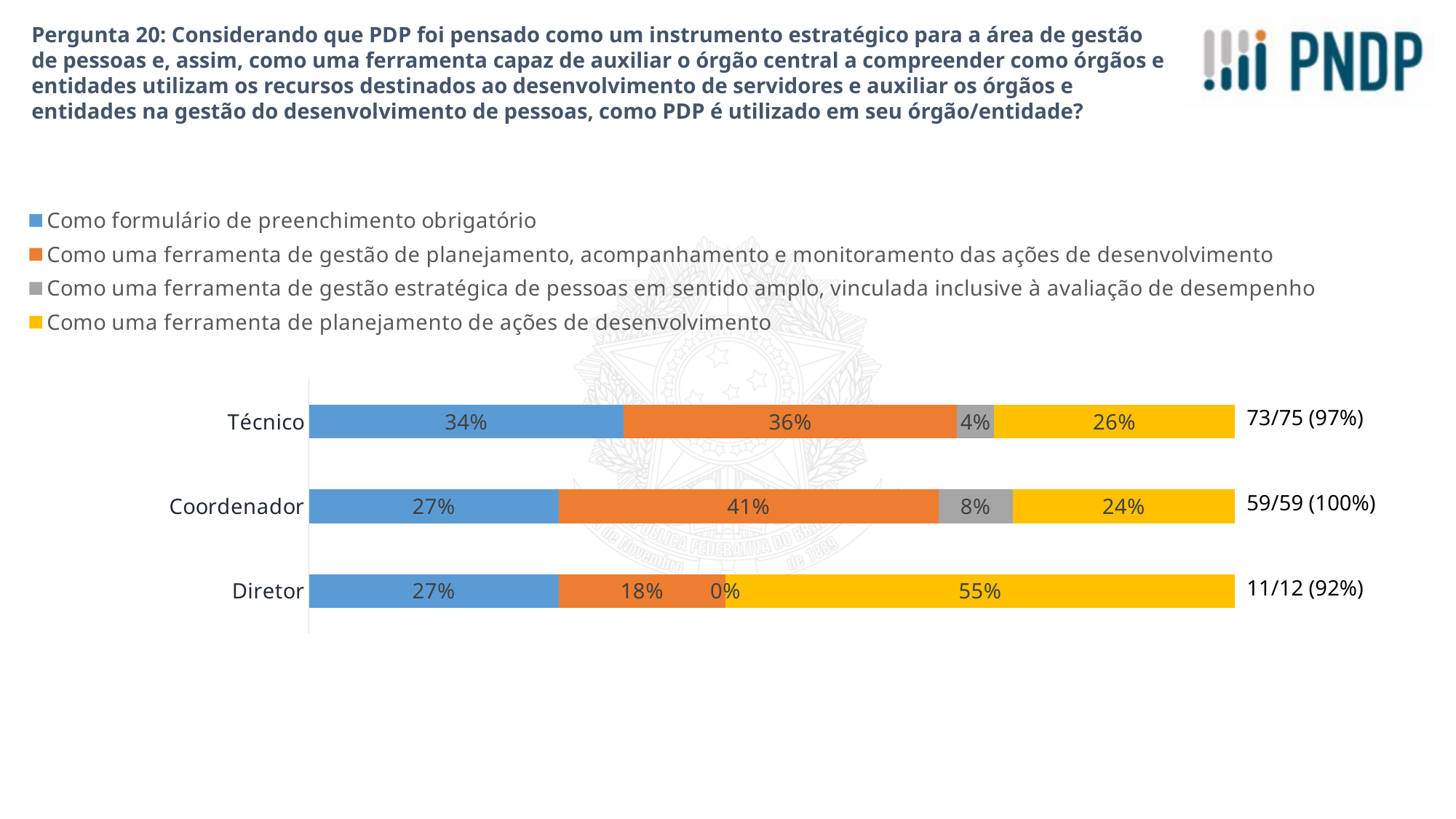
What is the difference between the Diretor and Técnico shares for 'Como uma ferramenta de planejamento de ações de desenvolvimento'? 29 percentage points Which job role has the lowest share for 'Como uma ferramenta de gestão estratégica de pessoas em sentido amplo, vinculada inclusive à avaliação de desempenho'? Diretor What percentage of Coordenador respondents chose 'Como uma ferramenta de gestão estratégica de pessoas em sentido amplo, vinculada inclusive à avaliação de desempenho'? 8% Which is larger: the Técnico share for 'Como formulário de preenchimento obrigatório' or the Coordenador share for the same option? Técnico How many categories (job roles) are shown on the chart? 3 What percentage of Técnico respondents chose 'Como formulário de preenchimento obrigatório'? 34% Which colour represents 'Como uma ferramenta de planejamento de ações de desenvolvimento' in the chart? Yellow What kind of chart is shown on the slide? Stacked bar chart Which job role has the highest share for 'Como uma ferramenta de gestão de planejamento, acompanhamento e monitoramento das ações de desenvolvimento'? Coordenador What response count and rate is shown next to the Coordenador bar? 59/59 (100%) How many series does the legend list? 4 What percentage of Diretor respondents chose 'Como uma ferramenta de planejamento de ações de desenvolvimento'? 55%